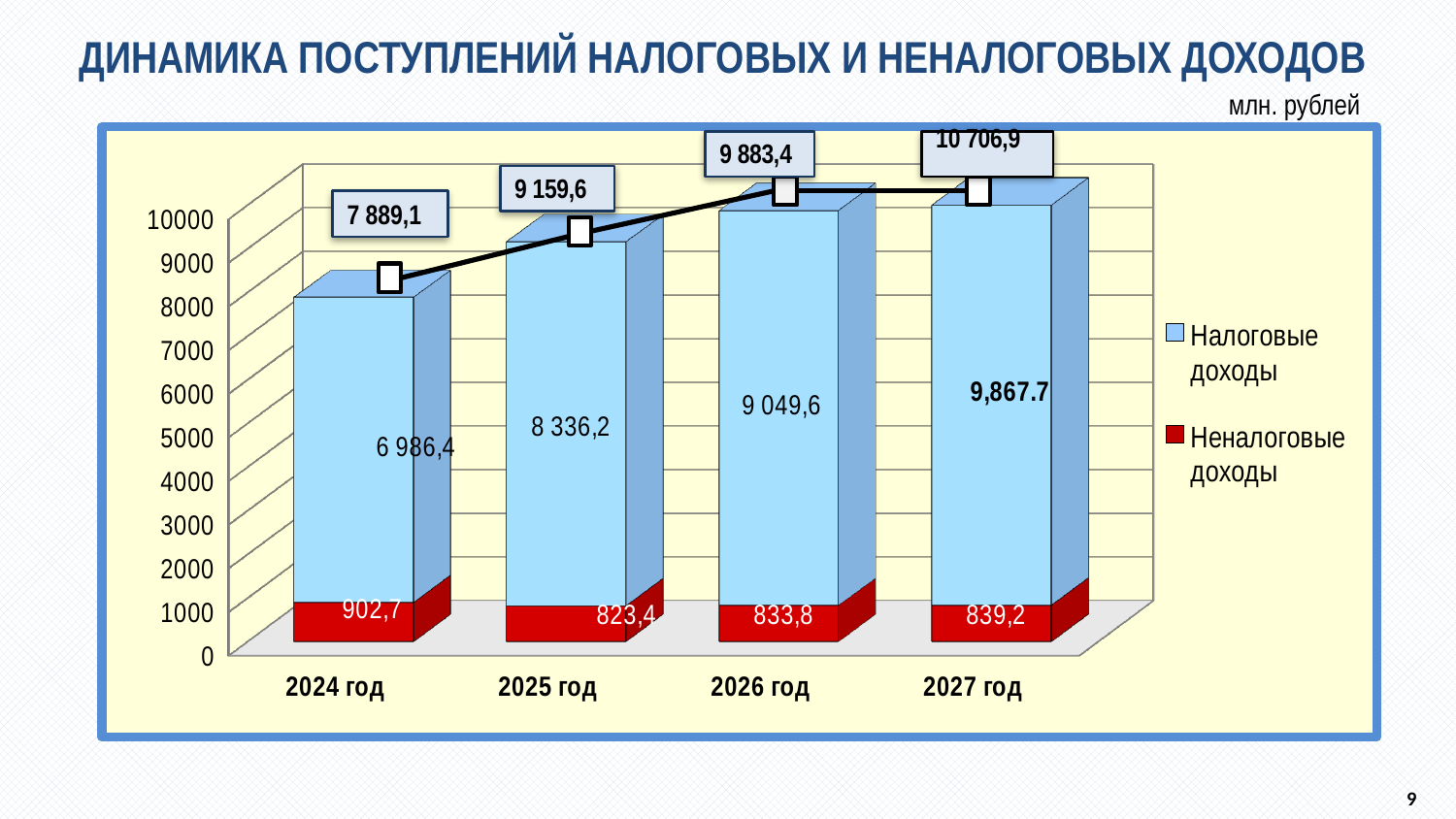
What is the value of Налоговые доходы for 2026 год? 9 049,6 What is the difference between the totals for 2025 год and 2024 год? 1 270,5 Do the totals rise or fall from 2024 год to 2027 год? Rise What total is shown above the bar for 2027 год? 10 706,9 Which is larger: Неналоговые доходы in 2026 год or in 2027 год? 2027 год How many series does the legend list? 2 Which year has the highest Налоговые доходы? 2027 год What is the value of Налоговые доходы for 2025 год? 8 336,2 How many years are shown on the x axis? 4 What is the value of Неналоговые доходы for 2024 год? 902,7 Which year has the lowest Неналоговые доходы? 2025 год What kind of chart is shown on the slide? Stacked bar chart with a line